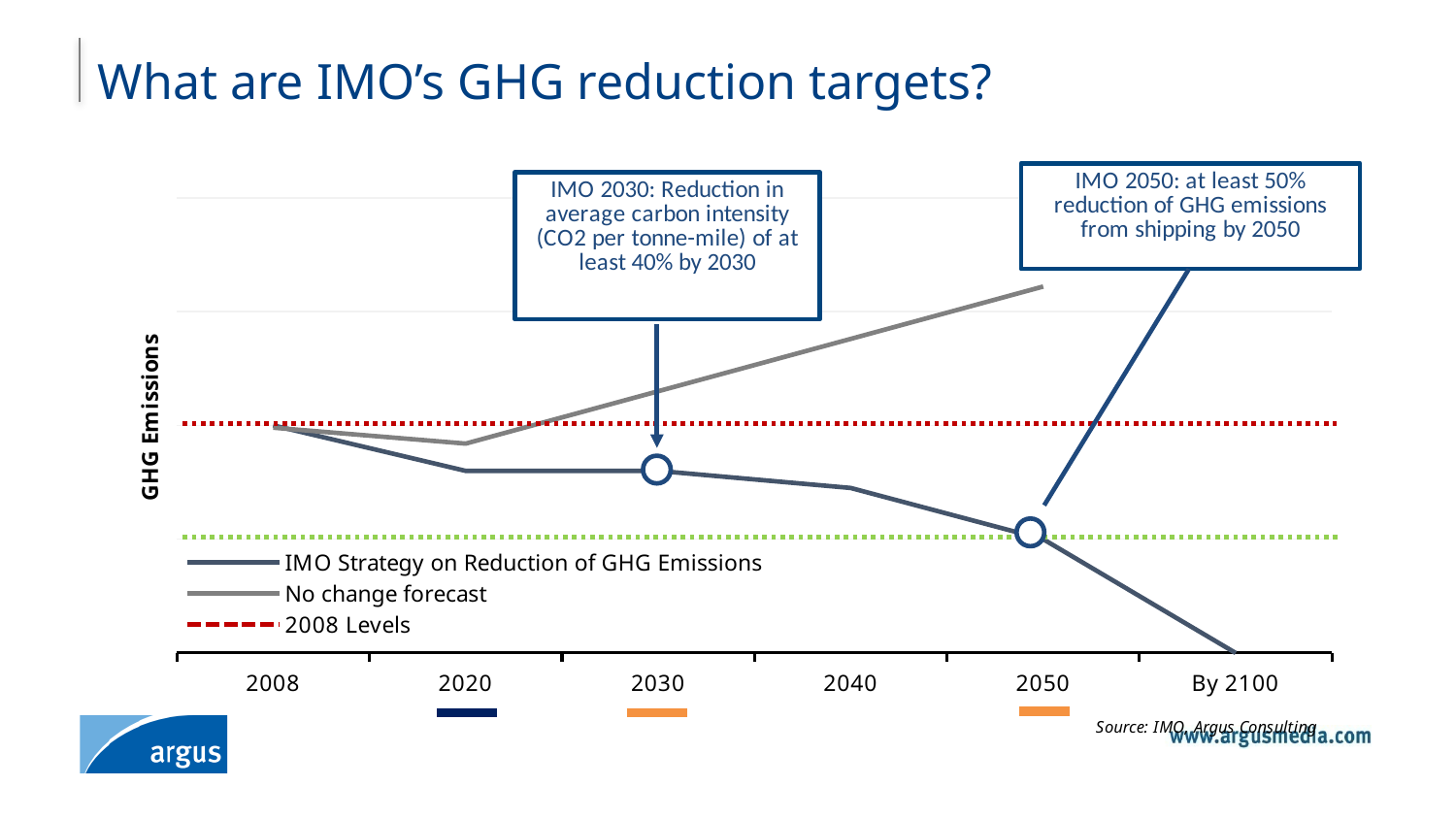
At 2050, which is higher: the No change forecast or the IMO Strategy on Reduction of GHG Emissions? No change forecast Does the IMO Strategy on Reduction of GHG Emissions line rise or fall from 2008 to By 2100? fall At which x-axis category does the IMO Strategy on Reduction of GHG Emissions line reach its lowest point? By 2100 At 2040, is the No change forecast line above or below the 2008 Levels line? above What kind of chart is shown on the slide? line chart How many categories are shown on the x axis? 6 What is the first category on the x axis? 2008 What is the last category on the x axis? By 2100 How many series does the legend list? 3 At 2030, is the IMO Strategy on Reduction of GHG Emissions line above or below the 2008 Levels line? below Does the No change forecast line rise or fall from 2008 to 2050? rise Which series is at its highest value at 2050? No change forecast